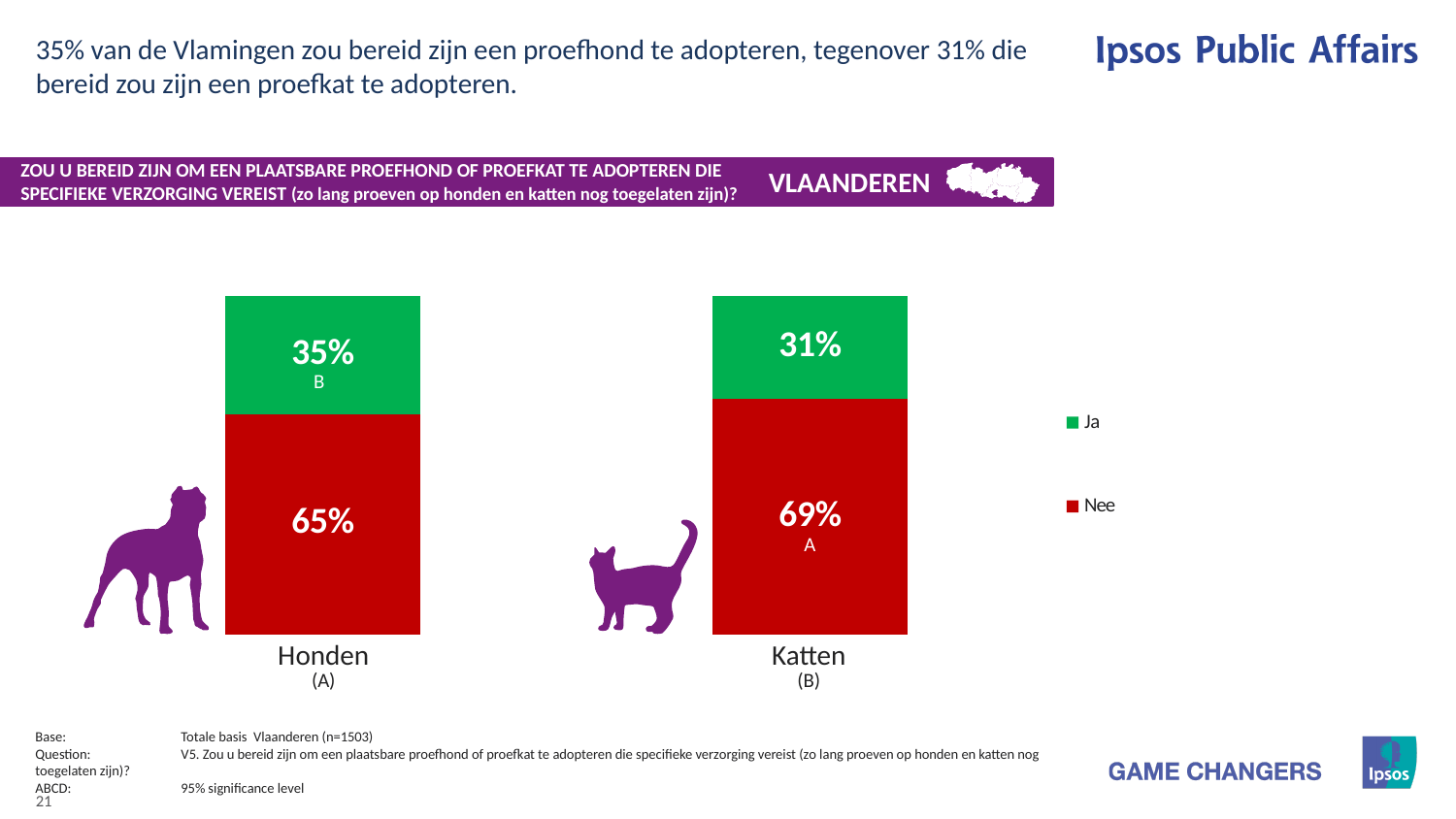
What colour represents 'Nee' in the chart? Red Which category has the highest 'Nee' value? Katten What kind of chart is shown? Stacked bar chart What is the 'Ja' value for Katten? 31% What is the 'Nee' value for Honden? 65% What is the 'Ja' value for Honden? 35% What is the difference between the 'Ja' values for Honden and Katten? 4% Which category has the higher 'Ja' value, Honden or Katten? Honden What is the 'Nee' value for Katten? 69% How many series does the legend list? 2 How many categories are shown on the x axis? 2 What is the difference between the 'Nee' values for Katten and Honden? 4%